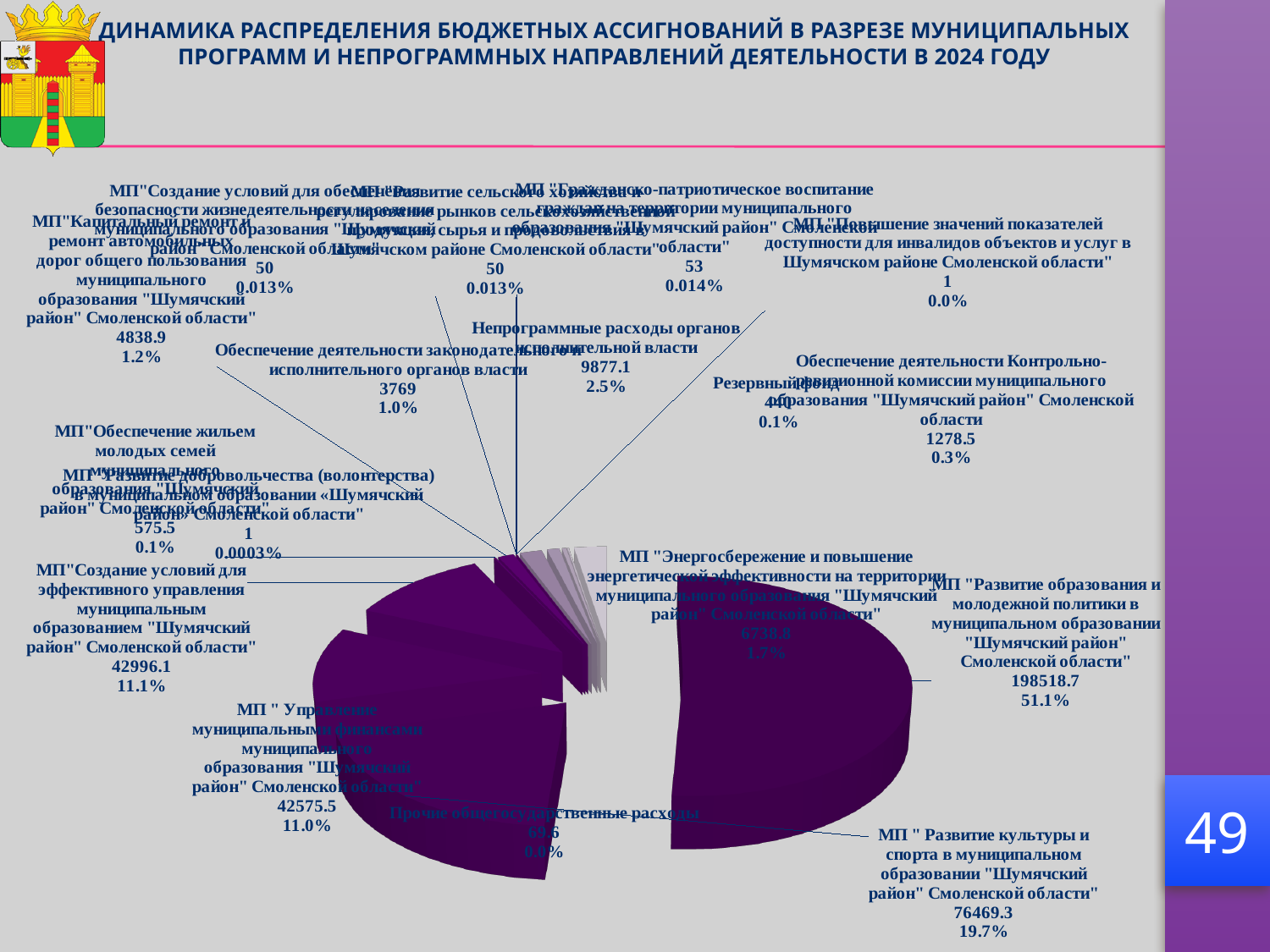
Which category has the largest share of the pie? МП "Развитие образования и молодежной политики в муниципальном образовании "Шумячский район" Смоленской области" What is the value shown for МП "Развитие культуры и спорта в муниципальном образовании "Шумячский район" Смоленской области"? 76469.3 What kind of chart is shown on the slide? pie chart Which is larger: the share for МП "Развитие культуры и спорта..." or the share for МП "Создание условий для эффективного управления муниципальным образованием..."? МП "Развитие культуры и спорта..." What value is shown for МП "Капитальный ремонт и ремонт автомобильных дорог общего пользования..."? 4838.9 What is the difference between the values for МП "Развитие образования и молодежной политики..." (198518.7) and МП "Развитие культуры и спорта..." (76469.3)? 122049.4 What is the percentage shown for Обеспечение деятельности законодательного и исполнительного органов власти? 1.0% What is the value shown for МП "Управление муниципальными финансами муниципального образования "Шумячский район" Смоленской области"? 42575.5 What percentage is shown for Непрограммные расходы органов исполнительной власти? 2.5% What share is shown for Обеспечение деятельности Контрольно-ревизионной комиссии муниципального образования "Шумячский район" Смоленской области? 0.3% What share of the budget goes to МП "Развитие образования и молодежной политики в муниципальном образовании "Шумячский район" Смоленской области"? 51.1% What is the difference between the values for МП "Создание условий для эффективного управления муниципальным образованием..." (42996.1) and МП "Управление муниципальными финансами..." (42575.5)? 420.6